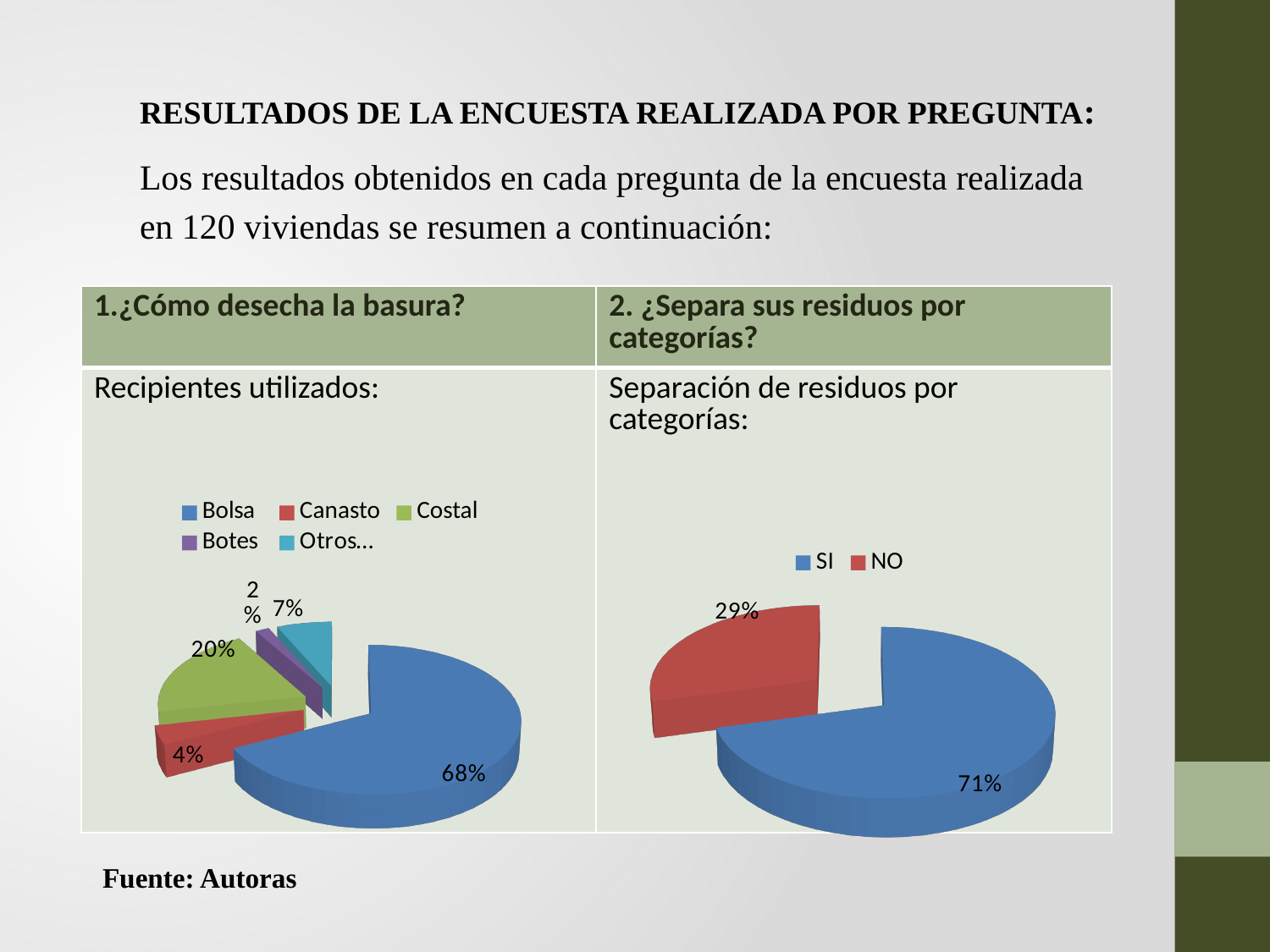
In the left pie chart (Recipientes utilizados), which category has the smallest share? Botes In the left pie chart (Recipientes utilizados), how many categories does the legend list? 5 In the left pie chart (Recipientes utilizados), what percentage is shown for Costal? 20% In the left pie chart (Recipientes utilizados), what percentage is shown for Canasto? 4% In the right pie chart (Separación de residuos por categorías), what percentage is shown for SI? 71% In the right pie chart (Separación de residuos por categorías), what is the difference in percentage points between SI and NO? 42 What type of chart is used in the right panel (Separación de residuos por categorías)? Pie chart In the left pie chart (Recipientes utilizados), what is the difference in percentage points between Bolsa and Costal? 48 In the right pie chart (Separación de residuos por categorías), what percentage is shown for NO? 29% In the left pie chart (Recipientes utilizados), which is larger, Costal or Otros...? Costal In the left pie chart (Recipientes utilizados), what percentage is shown for Bolsa? 68% In the left pie chart (Recipientes utilizados), which category has the largest share? Bolsa